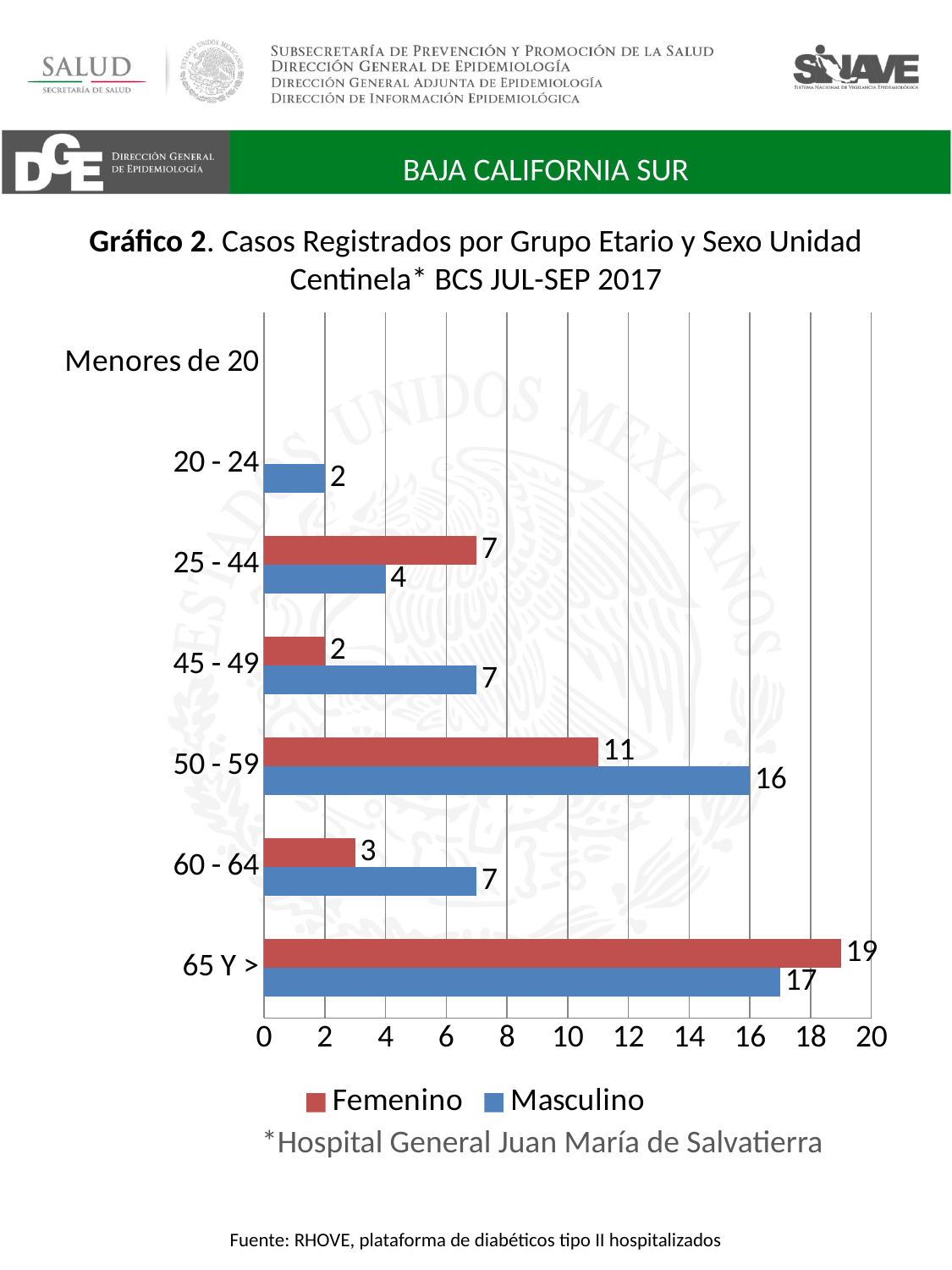
Which age group has the highest Femenino value? 65 Y > Which colour represents the Femenino series in the legend? Red What is the Masculino value for the 50 - 59 age group? 16 What is the Femenino value for the 25 - 44 age group? 7 For the 45 - 49 age group, which is larger, Femenino or Masculino? Masculino What is the total of the Femenino and Masculino values for the 65 Y > age group? 36 What is the Femenino value for the 65 Y > age group? 19 Which age group has the lowest Masculino value among those with a Masculino bar? 20 - 24 What kind of chart is shown on the slide? Bar chart How many series does the legend list? 2 What is the difference between the Femenino and Masculino values for the 50 - 59 age group? 5 How many age group categories are shown on the y axis? 7